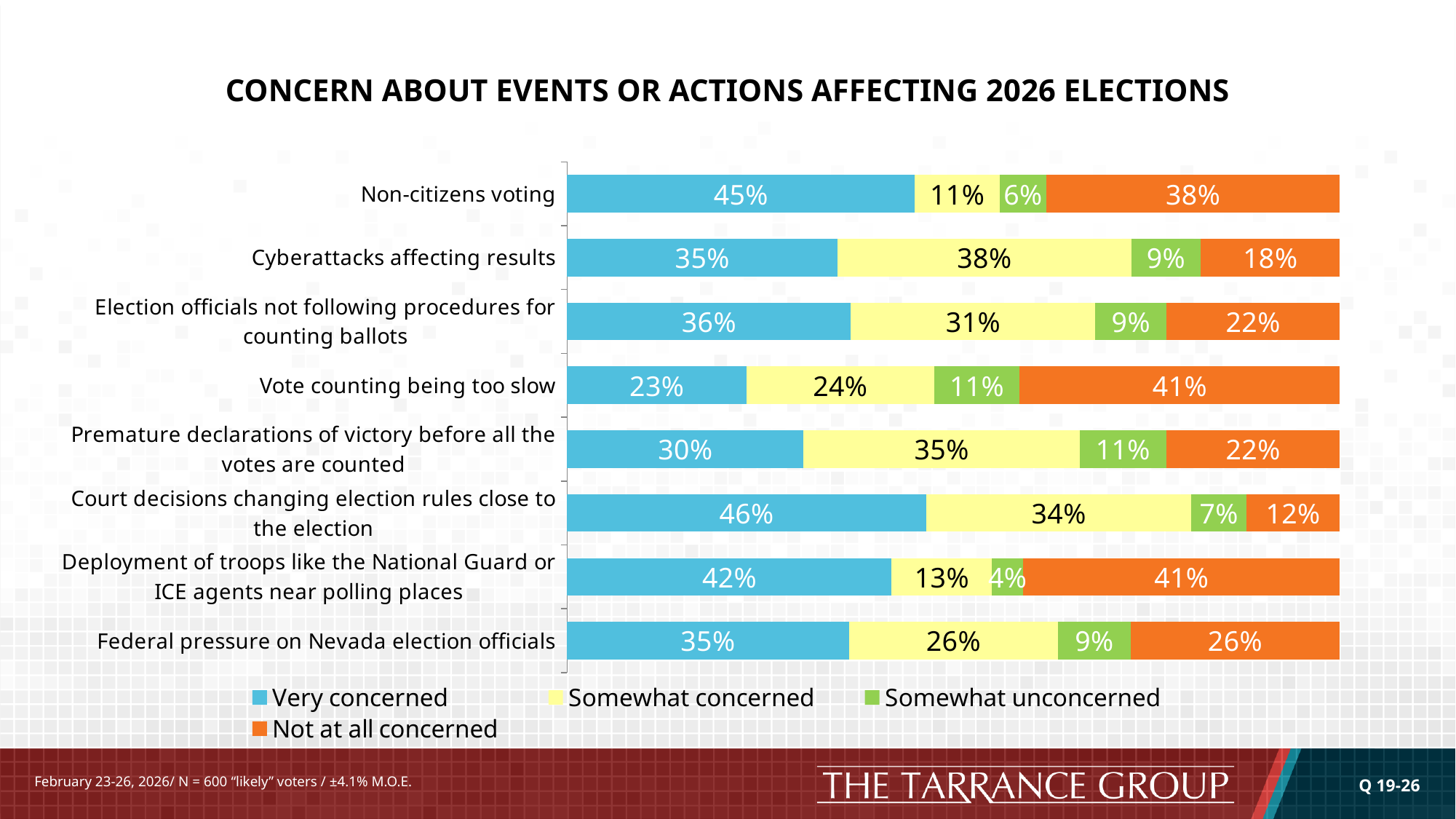
What percentage of respondents are not at all concerned about vote counting being too slow? 41% What percentage of respondents are very concerned about non-citizens voting? 45% Which item has the lowest share of respondents who are very concerned? Vote counting being too slow What percentage of respondents are somewhat unconcerned about deployment of troops like the National Guard or ICE agents near polling places? 4% For non-citizens voting, how many percentage points higher is the very concerned share than the not at all concerned share? 7 percentage points Which item has the highest share of respondents who are somewhat concerned? Cyberattacks affecting results What percentage of respondents are somewhat concerned about cyberattacks affecting results? 38% How many items (categories) are shown in the chart? 8 Is the very concerned share larger for court decisions changing election rules close to the election or for premature declarations of victory before all the votes are counted? Court decisions changing election rules close to the election How many series does the legend list? 4 Which item has the lowest share of respondents who are not at all concerned? Court decisions changing election rules close to the election What type of chart is shown on the slide? Stacked bar chart